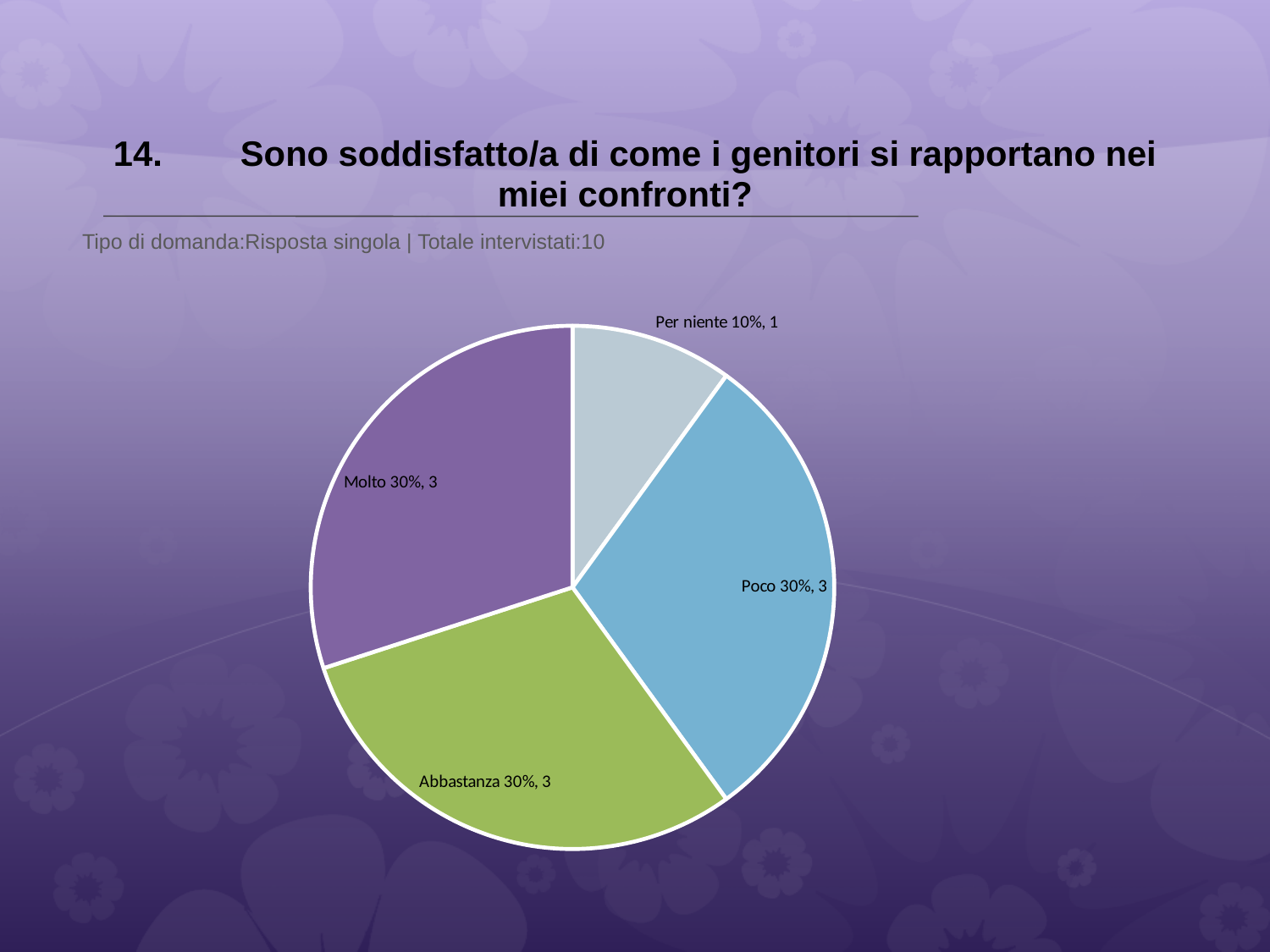
How many respondents answered "Per niente"? 1 How many respondents answered "Poco"? 3 What share of the pie does the "Molto" slice represent? 30% How many respondents answered "Abbastanza"? 3 Which slice is larger, "Poco" or "Per niente"? Poco What colour is the "Abbastanza" slice of the pie chart? green What share of the pie does the "Per niente" slice represent? 10% What is the total number of respondents (Totale intervistati) shown on the slide? 10 Which response category has the smallest slice of the pie? Per niente What is the difference in number of respondents between "Molto" and "Per niente"? 2 How many slices does the pie chart have? 4 What kind of chart is shown on the slide? pie chart